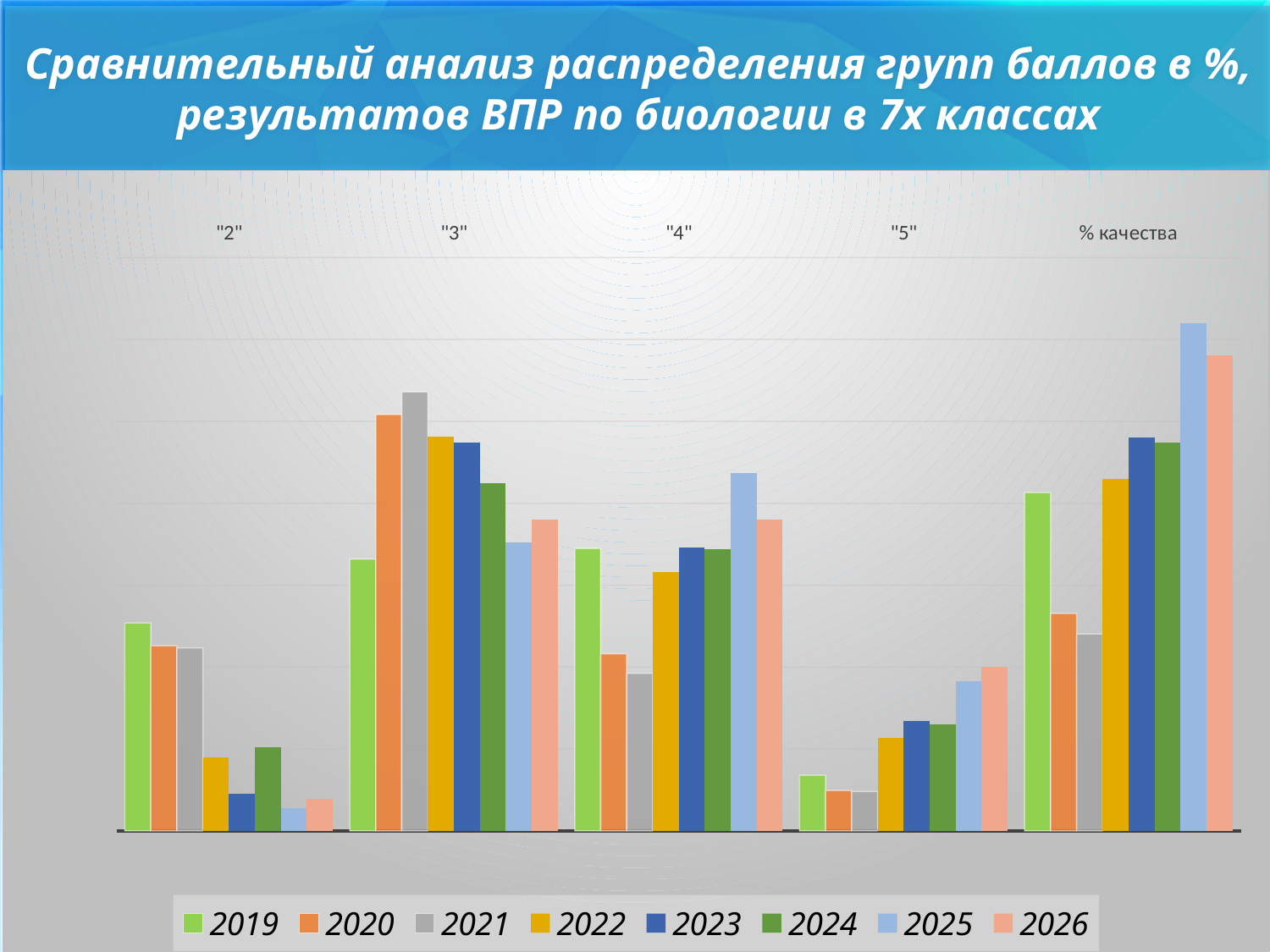
How many categories are shown along the x axis of the chart? 5 In the "4" category, which year has the shortest bar? 2021 In the "% качества" category, which is larger: the bar for 2026 or the bar for 2019? 2026 Which year is listed first in the chart legend? 2019 What kind of chart is shown on the slide? bar chart In the "% качества" category, which year has the tallest bar? 2025 In the "3" category, which year has the tallest bar? 2021 In the "2" category, which is larger: the bar for 2019 or the bar for 2022? 2019 In the "2" category, which year has the shortest bar? 2025 In the "4" category, which year has the tallest bar? 2025 How many series does the chart legend list? 8